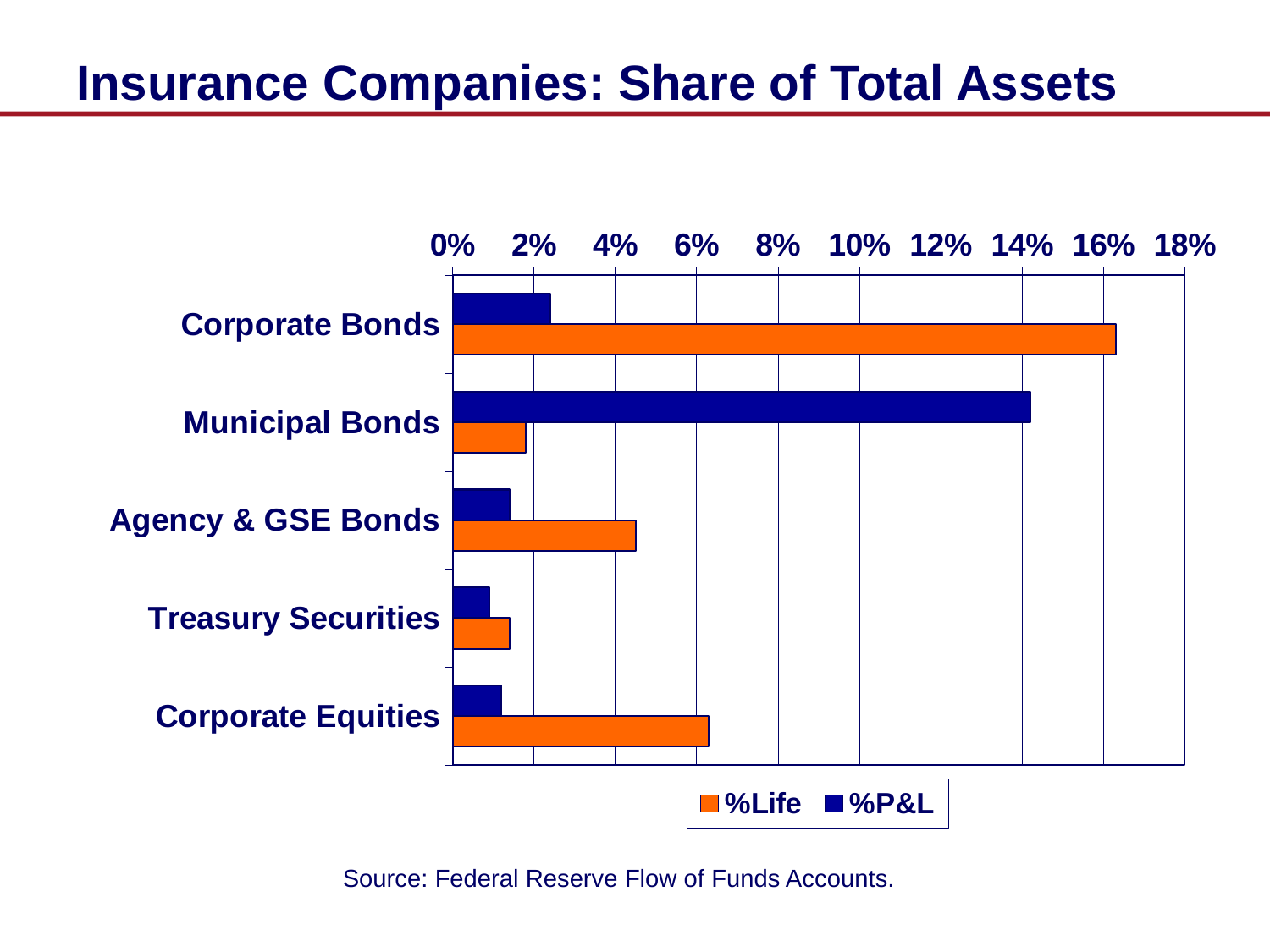
Which category has the highest %P&L value? Municipal Bonds How many series does the legend list? 2 Which category has the highest %Life value? Corporate Bonds For Corporate Equities, which is larger: %Life or %P&L? %Life Is the %Life value for Corporate Bonds greater or less than 14%? greater Is the %Life value for Treasury Securities greater or less than 2%? less For Municipal Bonds, which is larger: %Life or %P&L? %P&L What kind of chart is shown on the slide? bar chart Is the %Life value for Agency & GSE Bonds greater or less than 4%? greater What is the title of the chart? Insurance Companies: Share of Total Assets How many asset categories are shown on the chart? 5